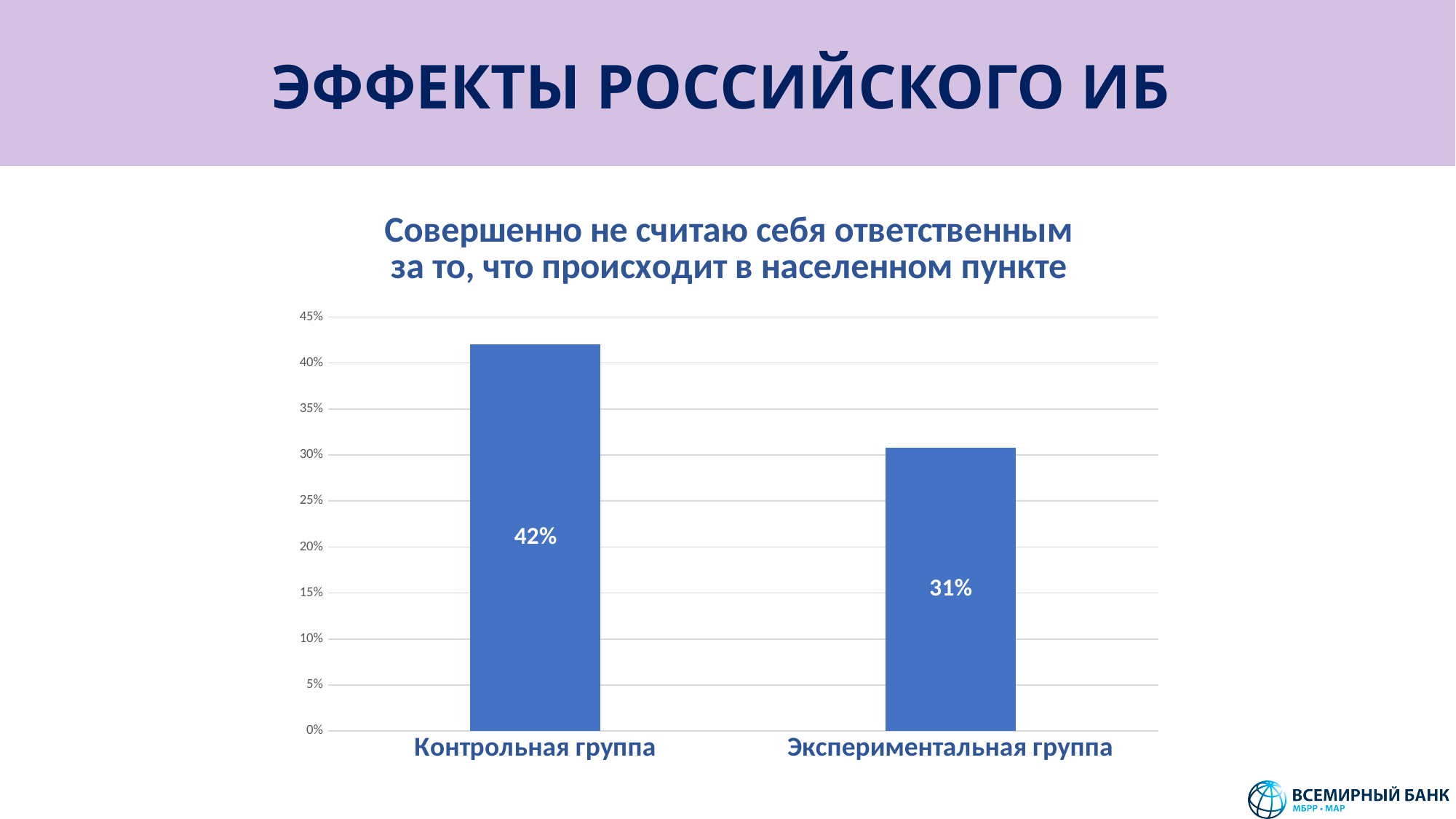
Which group has the lowest value? Экспериментальная группа What is the value for Экспериментальная группа? 31% Which group has the highest value? Контрольная группа What is the highest value shown on the vertical axis? 45% What kind of chart is shown on the slide? Bar chart What is the value for Контрольная группа? 42% What is the difference between the values for Контрольная группа and Экспериментальная группа? 11% What is the title of the chart? Совершенно не считаю себя ответственным за то, что происходит в населенном пункте How many categories are shown on the chart? 2 Which is larger: the value for Контрольная группа or for Экспериментальная группа? Контрольная группа Is the value for Экспериментальная группа greater or less than 35%? less Is the value for Контрольная группа greater or less than 40%? greater